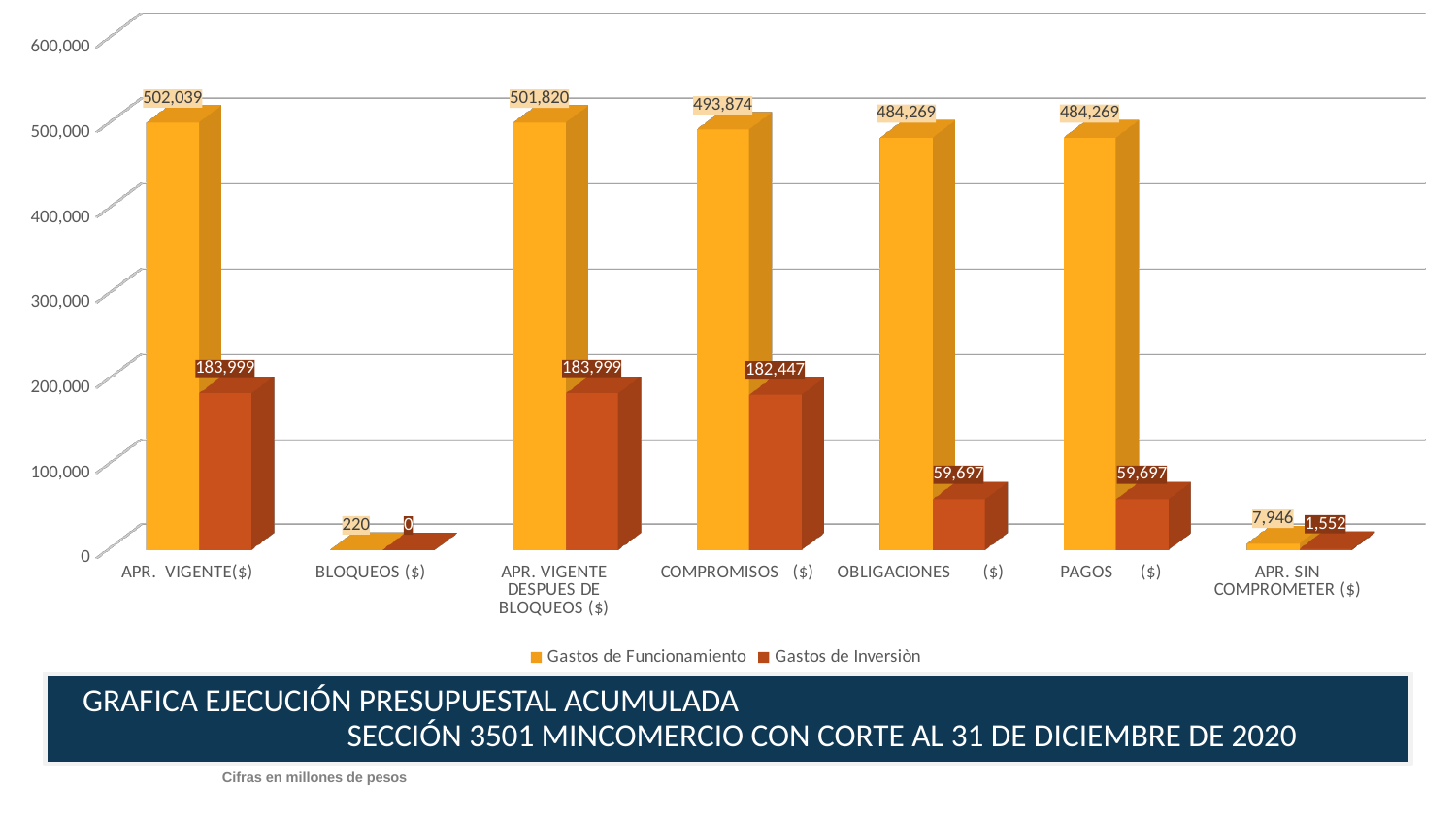
How many categories are shown on the x axis? 7 What is the value of Gastos de Funcionamiento for BLOQUEOS ($)? 220 What is the difference between Gastos de Funcionamiento and Gastos de Inversión for PAGOS ($)? 424,572 What is the value of Gastos de Inversión for APR. SIN COMPROMETER ($)? 1,552 What is the value of Gastos de Inversión for COMPROMISOS ($)? 182,447 What kind of chart is shown on the slide? Bar chart Which category has the lowest value for Gastos de Inversión? BLOQUEOS ($) How many series does the legend list? 2 What is the value of Gastos de Funcionamiento for APR. VIGENTE($)? 502,039 What unit note is printed below the chart title? Cifras en millones de pesos Which category has the highest value for Gastos de Funcionamiento? APR. VIGENTE($) Which is larger: Gastos de Inversión for APR. VIGENTE($) or Gastos de Inversión for OBLIGACIONES ($)? APR. VIGENTE($)